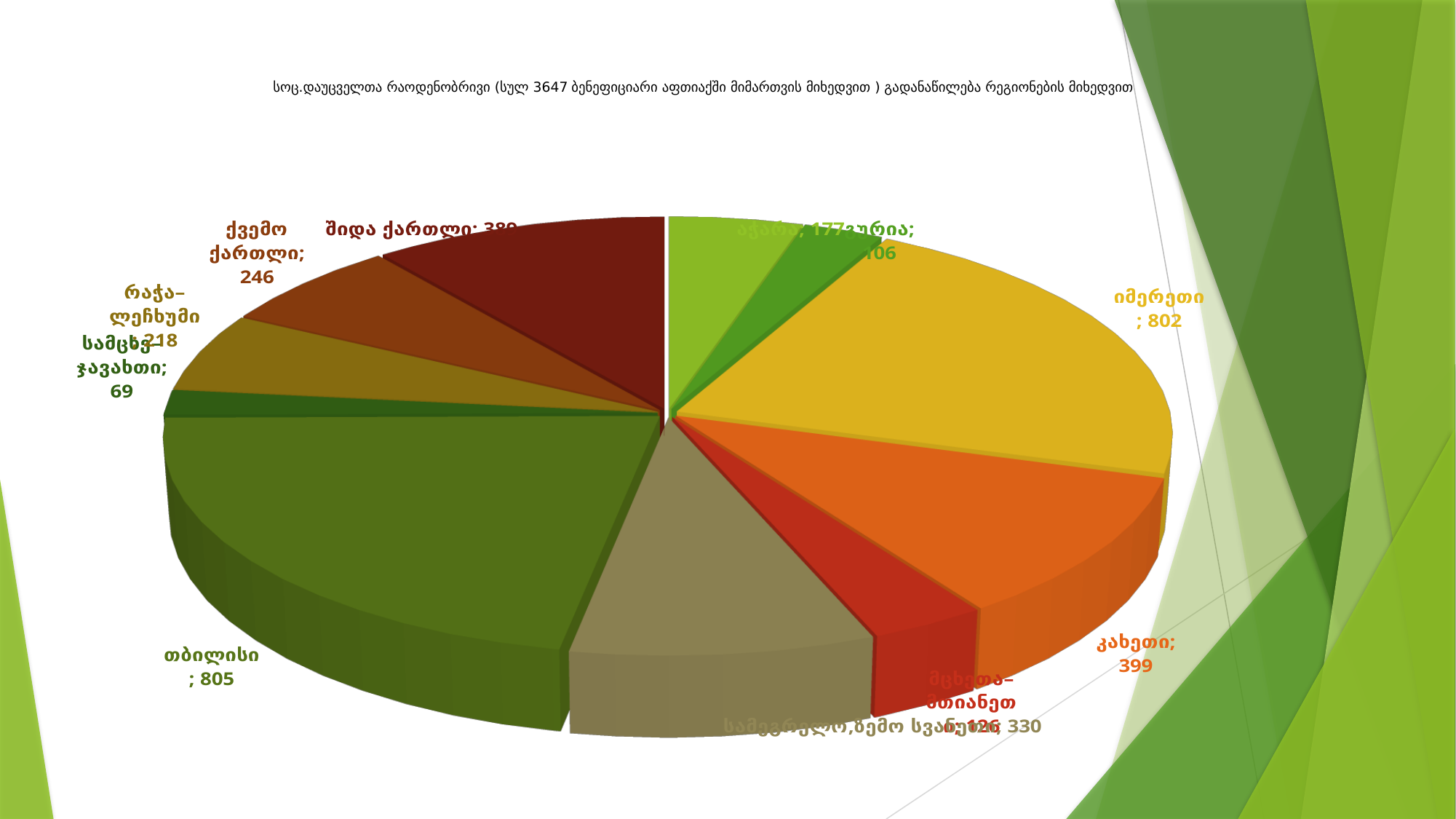
According to the chart title, what is the total number of beneficiaries? 3647 What is the value for თბილისი (Tbilisi) in the pie chart? 805 What is the difference between the values for კახეთი (Kakheti) and სამეგრელო-ზემო სვანეთი (Samegrelo-Zemo Svaneti)? 69 How many regions (slices) are shown in the pie chart? 11 What is the value for იმერეთი (Imereti) in the pie chart? 802 Which region has the smallest slice in the pie chart? სამცხე-ჯავახეთი (Samtskhe-Javakheti) Which is larger, the value for ქვემო ქართლი (Kvemo Kartli) or რაჭა-ლეჩხუმი (Racha-Lechkhumi)? ქვემო ქართლი (Kvemo Kartli) What type of chart is shown on the slide? pie chart What is the value for სამცხე-ჯავახეთი (Samtskhe-Javakheti) in the pie chart? 69 Which region has the largest slice in the pie chart? თბილისი (Tbilisi) What is the value for ქვემო ქართლი (Kvemo Kartli) in the pie chart? 246 What is the value for კახეთი (Kakheti) in the pie chart? 399